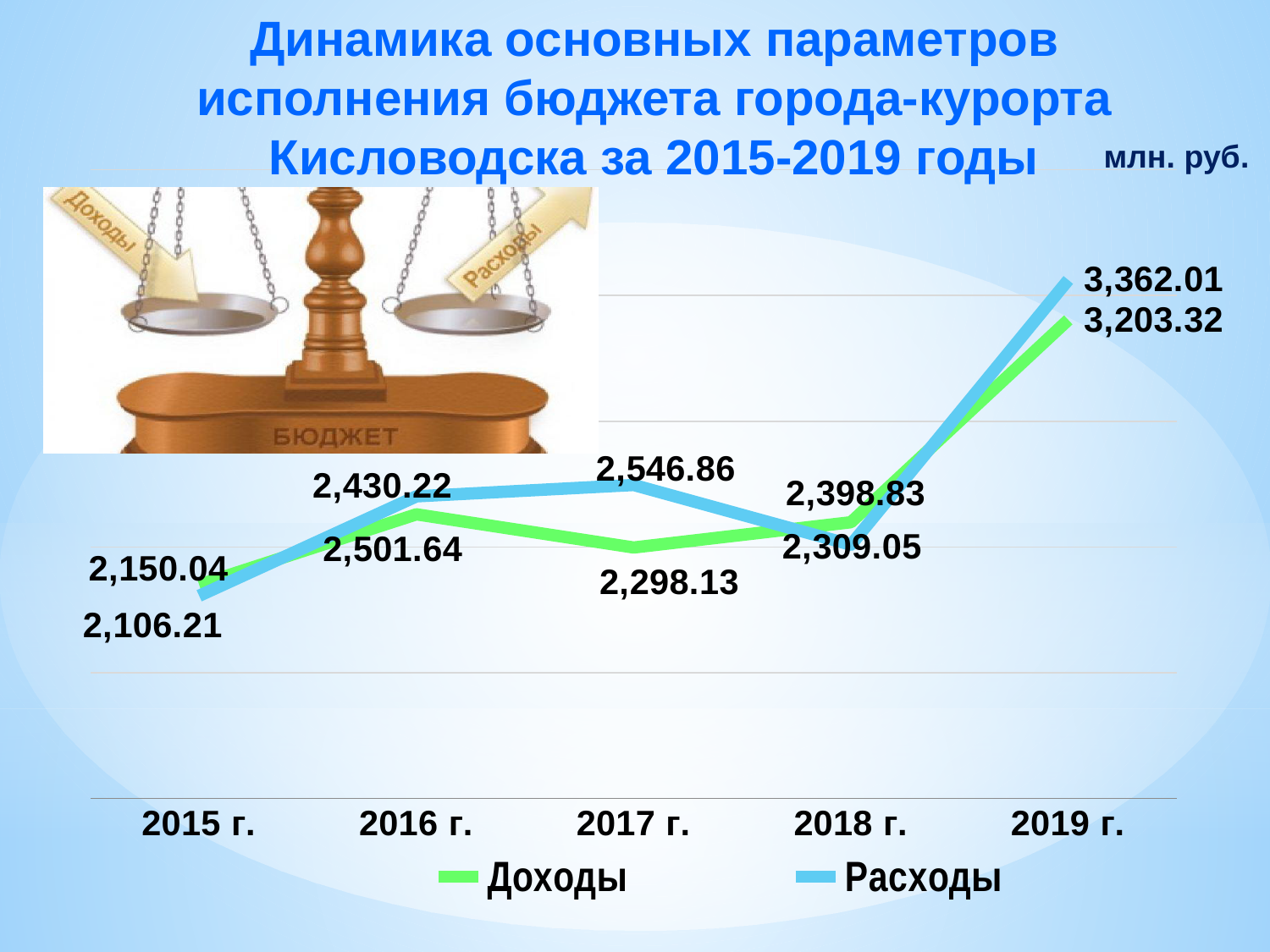
Which is larger in 2017 г., Доходы or Расходы? Расходы How many series does the legend list? 2 What is the value of Доходы for 2019 г.? 3,203.32 What is the value of Расходы for 2017 г.? 2,546.86 What is the difference between Расходы and Доходы in 2019 г.? 158.69 What is the value of Доходы for 2017 г.? 2,298.13 How many years are plotted along the x axis? 5 What is the value of Расходы for 2019 г.? 3,362.01 What unit is indicated for the values on the chart? млн. руб. In which year are Доходы the lowest? 2015 г. What kind of chart is shown on the slide? line chart In which year are Расходы the highest? 2019 г.